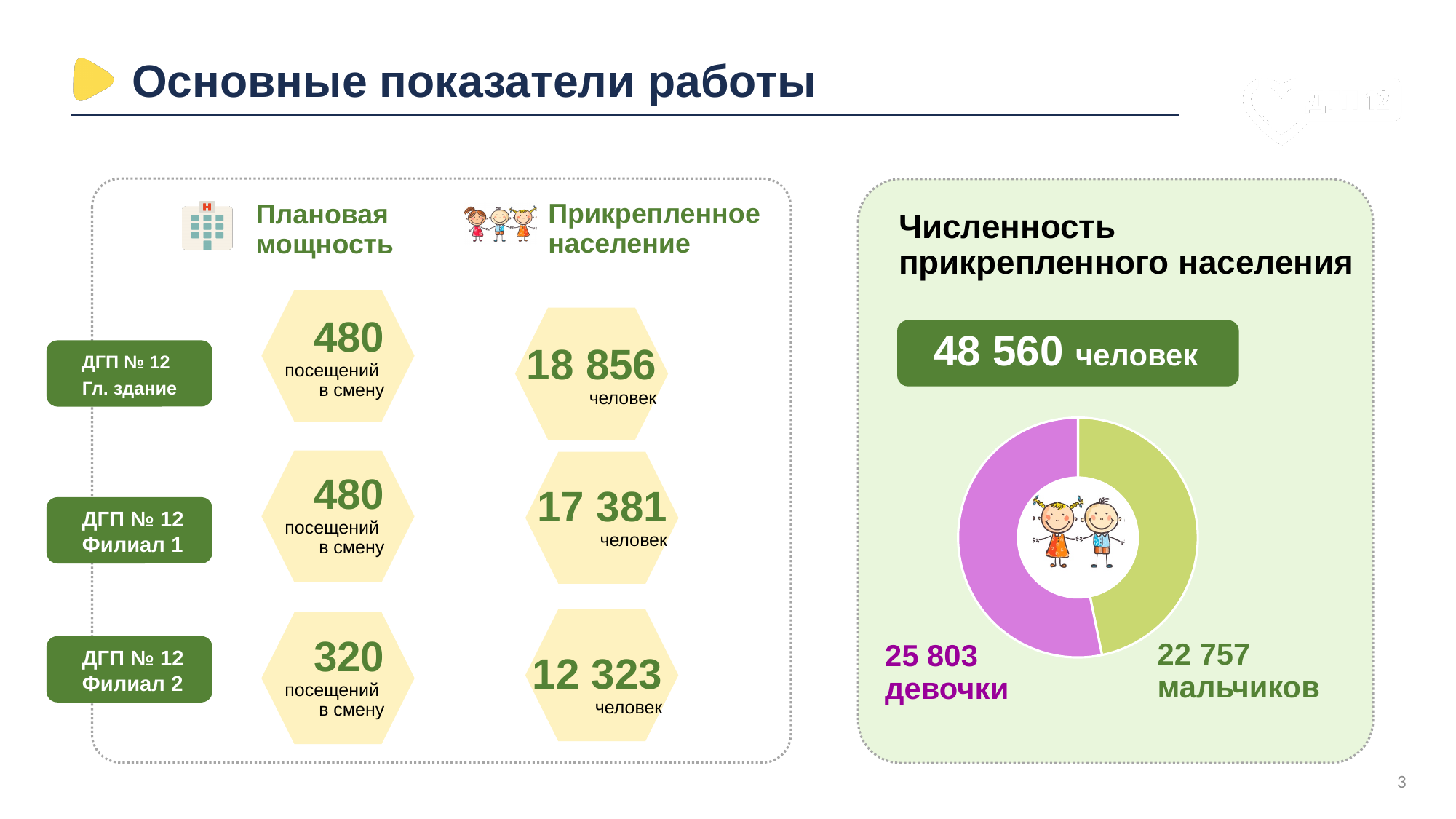
Which slice of the 'Численность прикрепленного населения' chart is the smallest? мальчиков In the 'Численность прикрепленного населения' chart, what share of the total do девочки make up? 53.1% In the 'Численность прикрепленного населения' chart, by how much does the number of девочки exceed the number of мальчиков? 3 046 What kind of chart is shown in the 'Численность прикрепленного населения' panel? pie chart (donut) What colour is the девочки slice in the 'Численность прикрепленного населения' chart? pink/purple In the 'Численность прикрепленного населения' chart, how many девочки are there? 25 803 How many slices does the 'Численность прикрепленного населения' chart have? 2 What is the total number of people shown in the 'Численность прикрепленного населения' chart? 48 560 человек In the 'Численность прикрепленного населения' chart, which group is larger, девочки or мальчики? девочки What is the title of the chart panel on the right side of the slide? Численность прикрепленного населения In the 'Численность прикрепленного населения' chart, how many мальчиков are there? 22 757